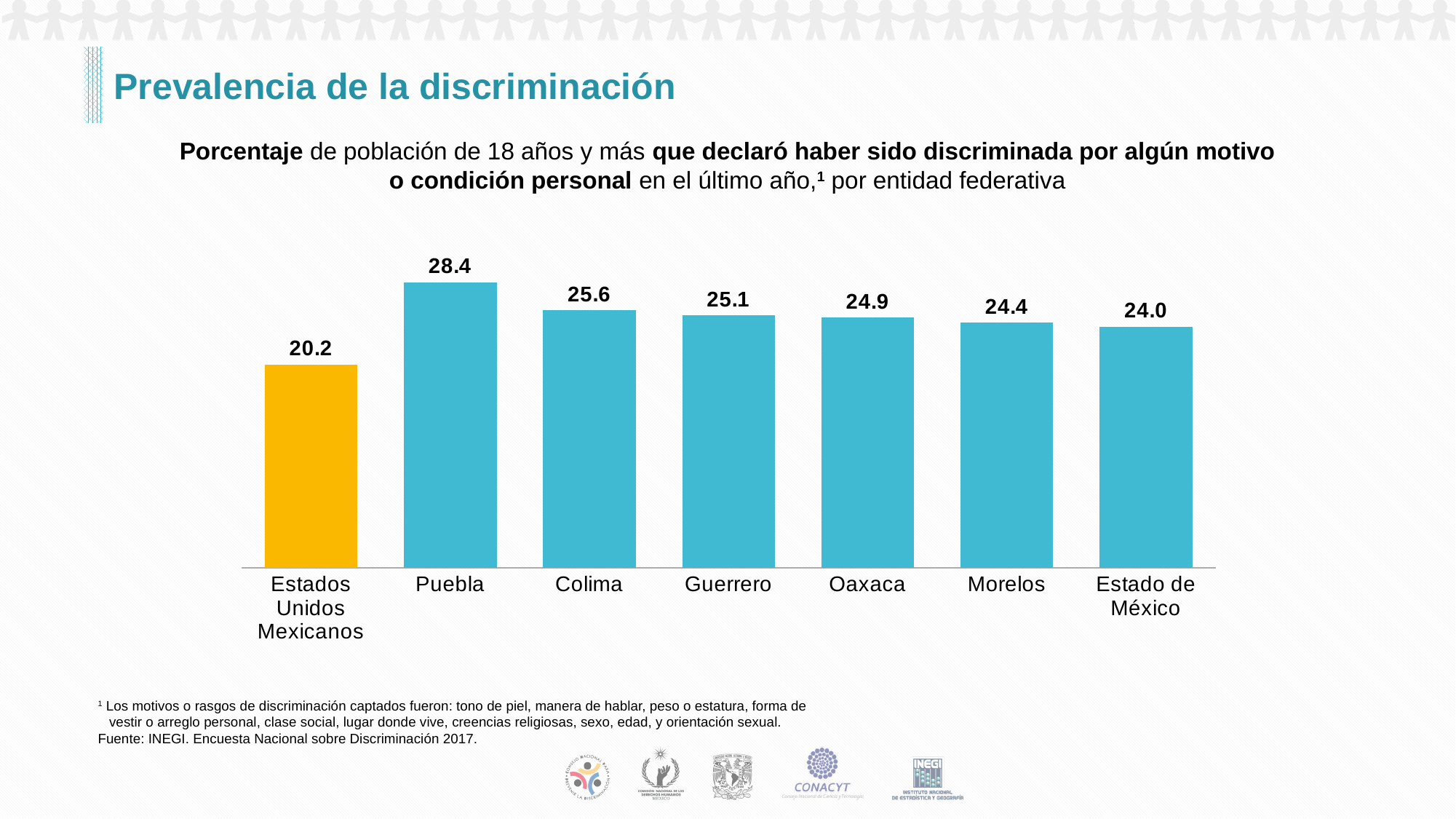
What is the value for Puebla? 28.4 Which category has the highest value? Puebla What is the difference between the values for Puebla and Colima? 2.8 What kind of chart is shown on the slide? Bar chart What is the value for Oaxaca? 24.9 How many categories are shown in the chart? 7 Which is larger, the value for Colima or the value for Morelos? Colima What is the value for Estado de México? 24.0 What is the difference between the values for Guerrero and Estados Unidos Mexicanos? 4.9 Which bar is shown in a different colour (orange) from the others? Estados Unidos Mexicanos What is the value for Estados Unidos Mexicanos? 20.2 Which category has the lowest value? Estados Unidos Mexicanos